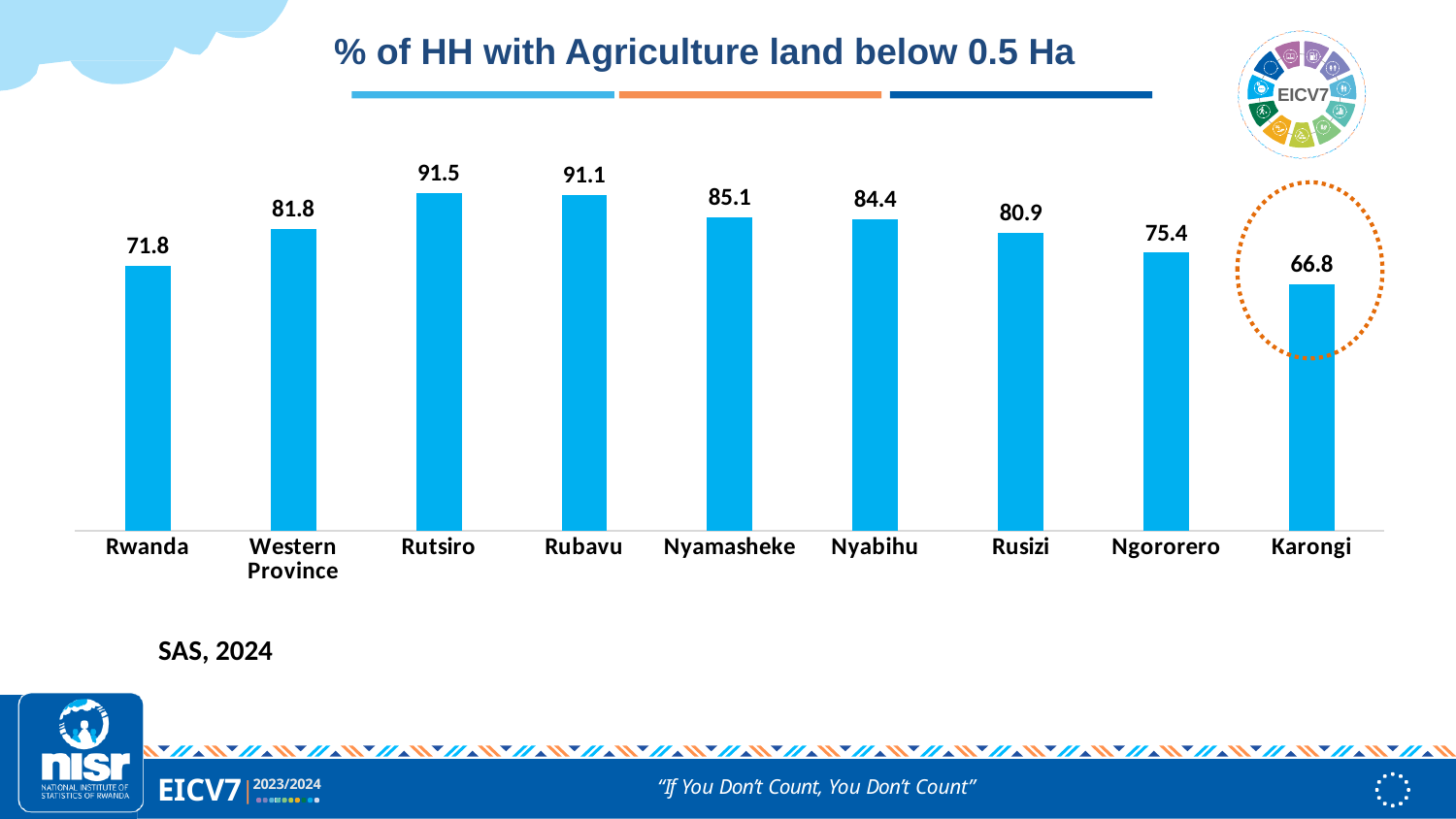
What is the value for Rutsiro? 91.5 What is the value for Karongi? 66.8 Which category has the lowest value? Karongi What is the title of the chart? % of HH with Agriculture land below 0.5 Ha What is the value for Western Province? 81.8 Which category has the highest value? Rutsiro What is the value for Rwanda? 71.8 Which is larger, the value for Nyamasheke or the value for Rusizi? Nyamasheke What is the difference between the values for Rutsiro and Karongi? 24.7 How many categories are shown on the x axis? 9 What kind of chart is shown on the slide? bar chart What is the difference between the values for Western Province and Rwanda? 10